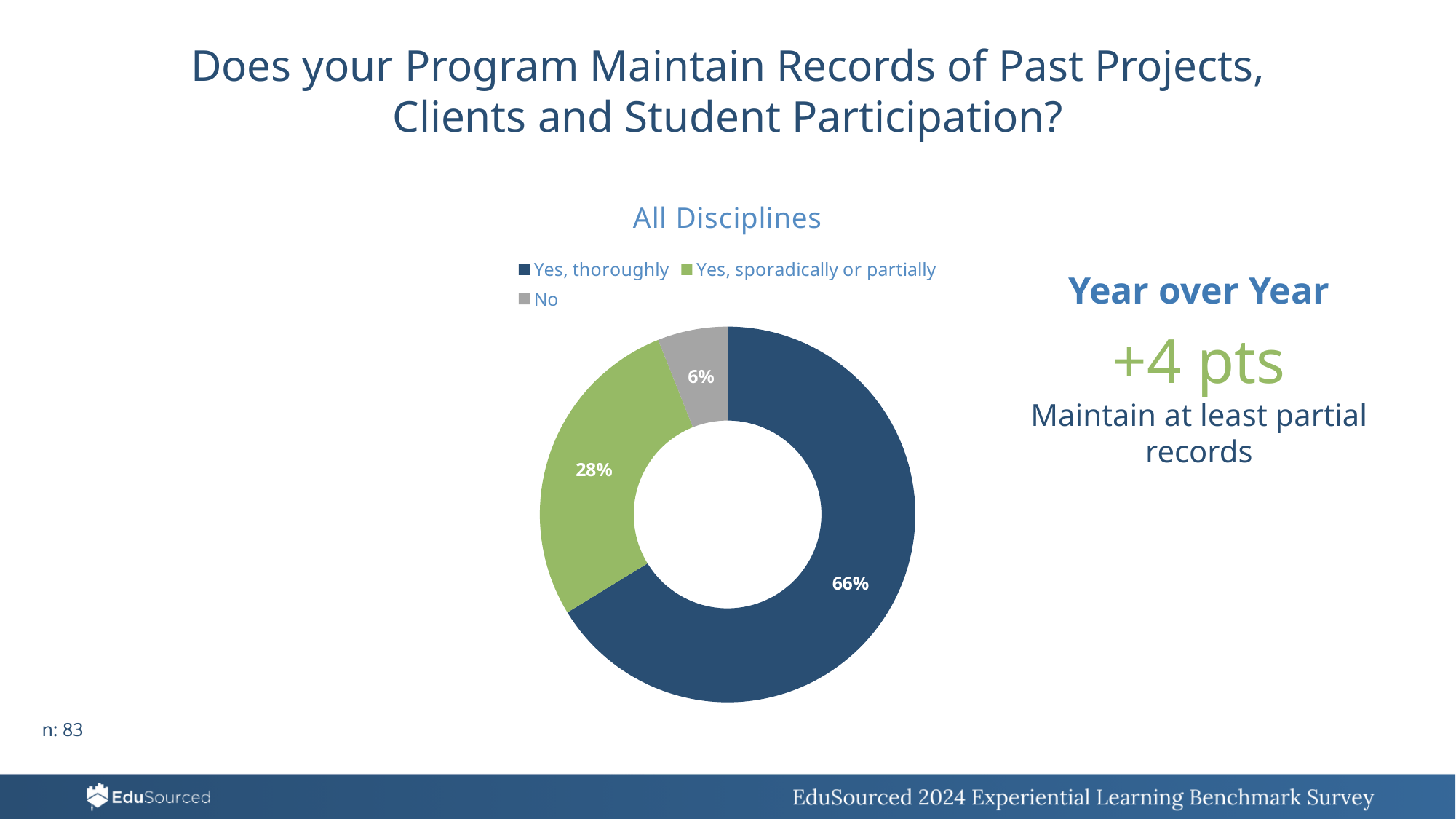
How many response categories does the chart show? 3 What colour represents the "No" category in the chart? Grey Which is larger, the share for "Yes, sporadically or partially" or the share for "No"? Yes, sporadically or partially What kind of chart is shown on the slide? Doughnut (pie) chart What is the title of the chart? All Disciplines What percentage of respondents answered "No"? 6% What is the difference in percentage points between "Yes, thoroughly" and "Yes, sporadically or partially"? 38 Which response has the largest share of the chart? Yes, thoroughly What percentage of respondents answered "Yes, thoroughly"? 66% What is the combined share of respondents who maintain at least partial records ("Yes, thoroughly" plus "Yes, sporadically or partially")? 94% What percentage of respondents answered "Yes, sporadically or partially"? 28% Which response has the smallest share of the chart? No